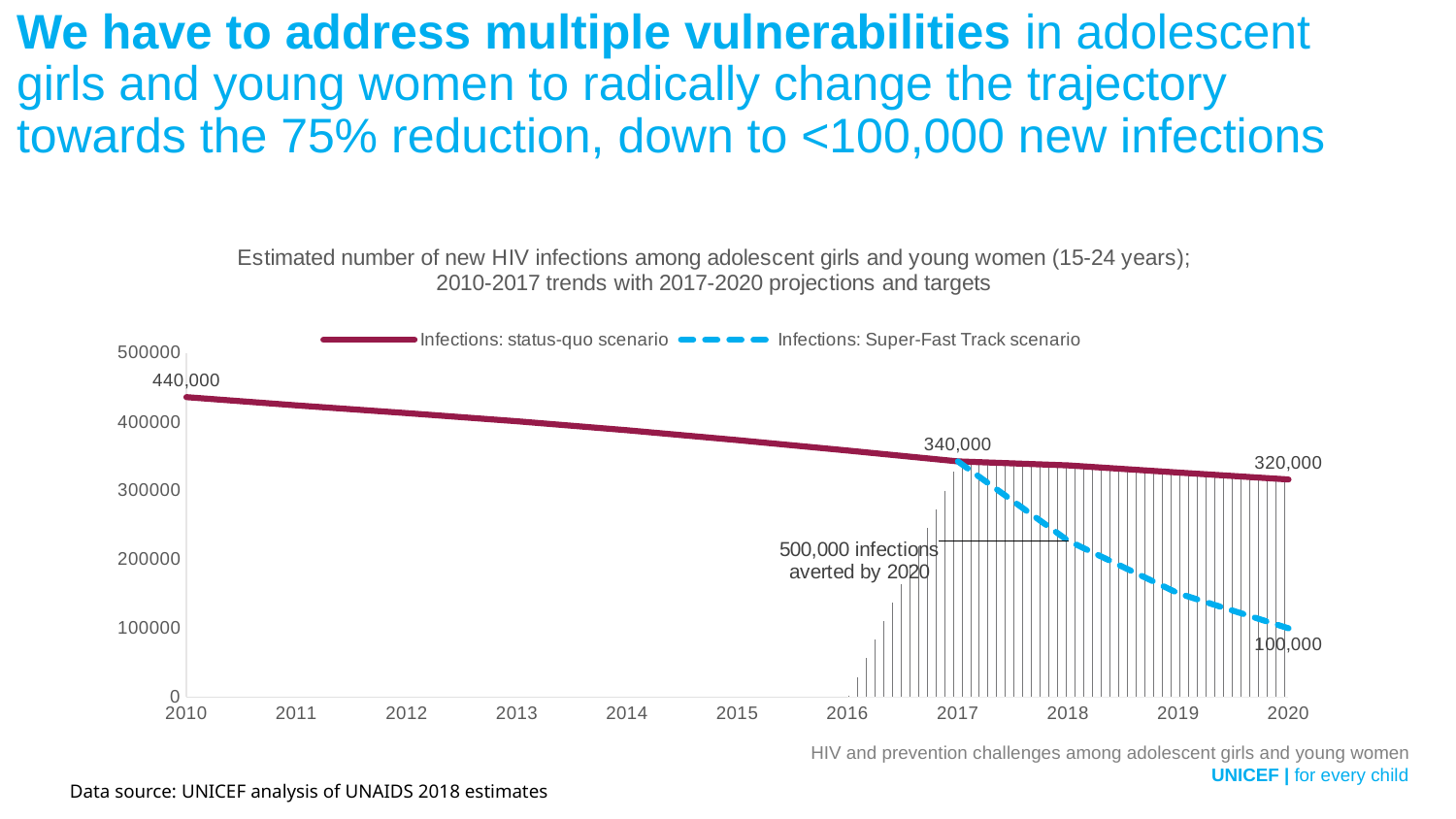
What kind of chart is shown on the slide? Line chart Is the value for the status-quo scenario in 2014 greater or less than 300000? greater What is the value shown for 2017, where the two scenarios diverge? 340,000 What is the difference between the status-quo scenario and the Super-Fast Track scenario in 2020? 220,000 What is the value for the status-quo scenario in 2020? 320,000 Which scenario has the larger value in 2020, status-quo or Super-Fast Track? Infections: status-quo scenario Do the values for the status-quo scenario rise or fall from 2010 to 2020? Fall Is the value for the Super-Fast Track scenario in 2019 greater or less than 200000? less By how much does the status-quo scenario fall from 2010 to 2020? 120,000 How many series does the legend list? 2 What is the value for the Super-Fast Track scenario in 2020? 100,000 What is the value for the status-quo scenario in 2010? 440,000